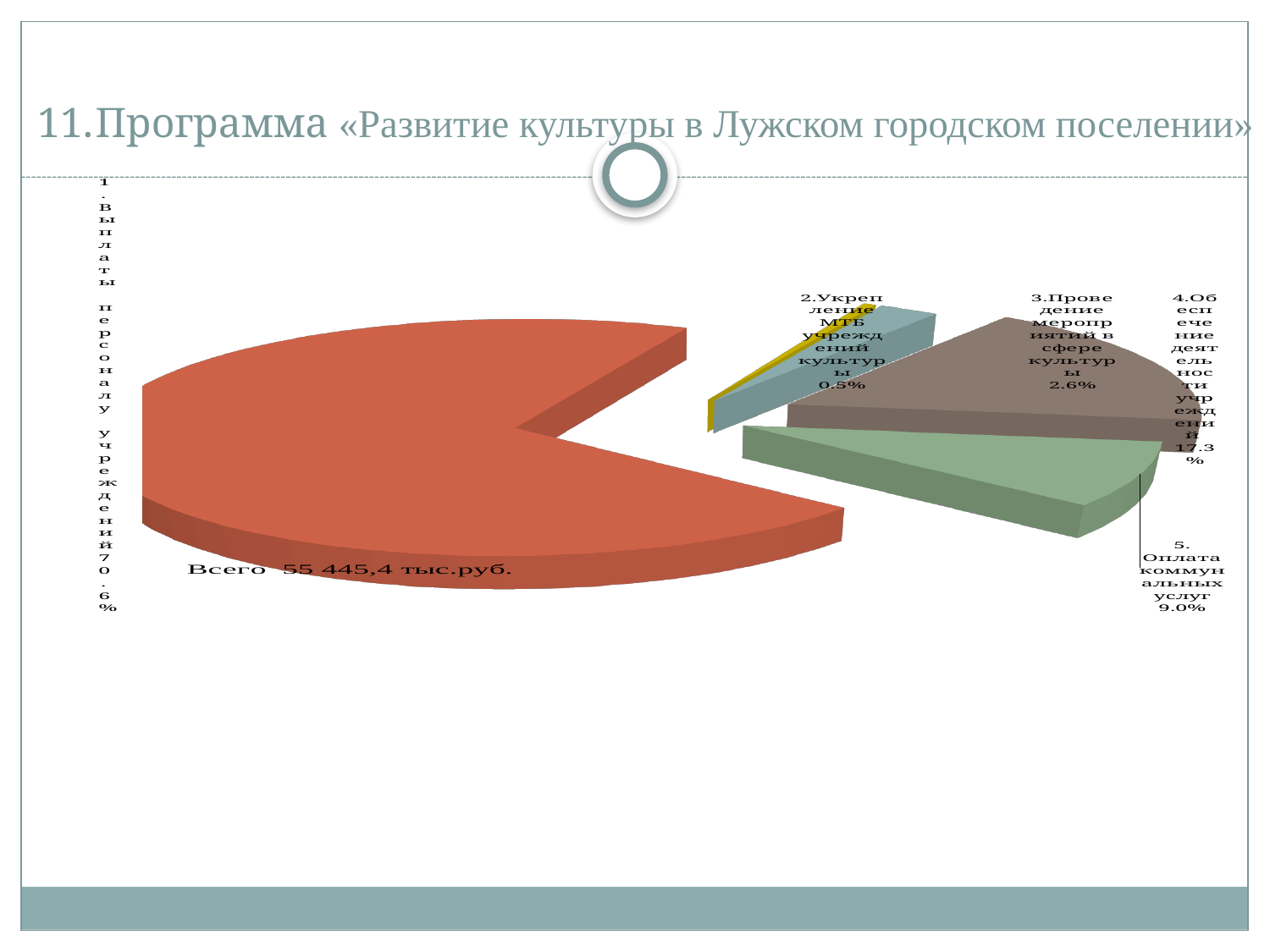
What kind of chart is shown on the slide? pie chart What share of the pie does "2.Укрепление МТБ учреждений культуры" take? 0.5% What share of the pie does "1.Выплаты персоналу учреждений" take? 70.6% Which slice of the pie chart is the smallest? 2.Укрепление МТБ учреждений культуры What share of the pie does "4.Обеспечение деятельности учреждений" take? 17.3% Which is larger: the share for "3.Проведение мероприятий в сфере культуры" or for "5.Оплата коммунальных услуг"? 5.Оплата коммунальных услуг Which slice of the pie chart is the largest? 1.Выплаты персоналу учреждений How many slices does the pie chart have? 5 What total amount is printed on the pie chart? Всего 55 445,4 тыс.руб. What is the difference in percentage points between "4.Обеспечение деятельности учреждений" and "5.Оплата коммунальных услуг"? 8.3